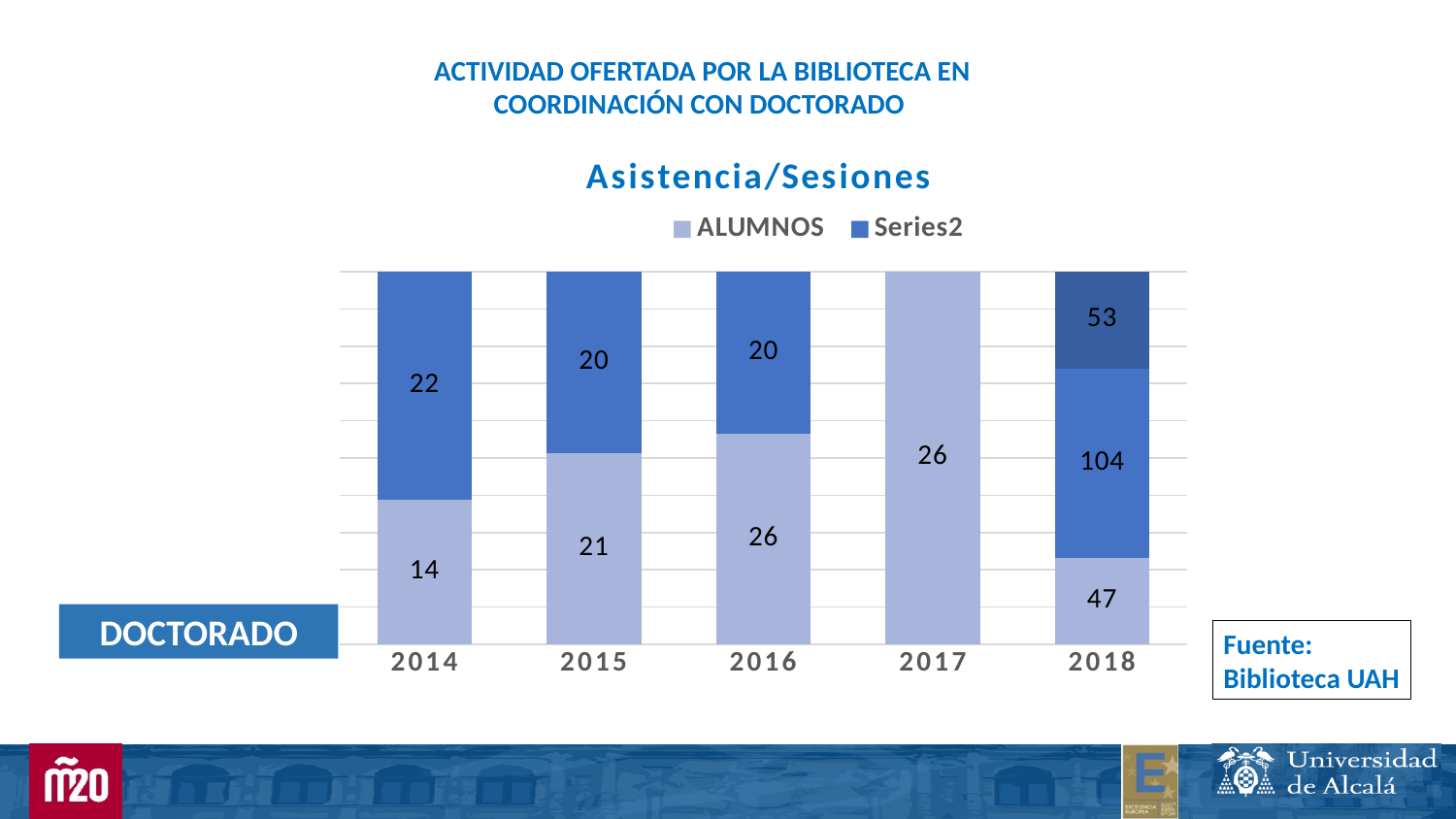
Which year has the lowest ALUMNOS value? 2014 Which year has the highest ALUMNOS value? 2018 How many years are shown on the x axis of the chart? 5 What is the difference between the Series2 value for 2018 and the Series2 value for 2014? 82 What is the title of the chart? Asistencia/Sesiones Which is larger, the ALUMNOS value for 2015 or the ALUMNOS value for 2016? 2016 What is the total of the labelled values in the 2014 bar? 36 What is the Series2 value for 2018? 104 What is the ALUMNOS value for 2014? 14 What type of chart is shown on the slide? Stacked bar chart What is the ALUMNOS value for 2017? 26 How many series does the chart legend list? 2